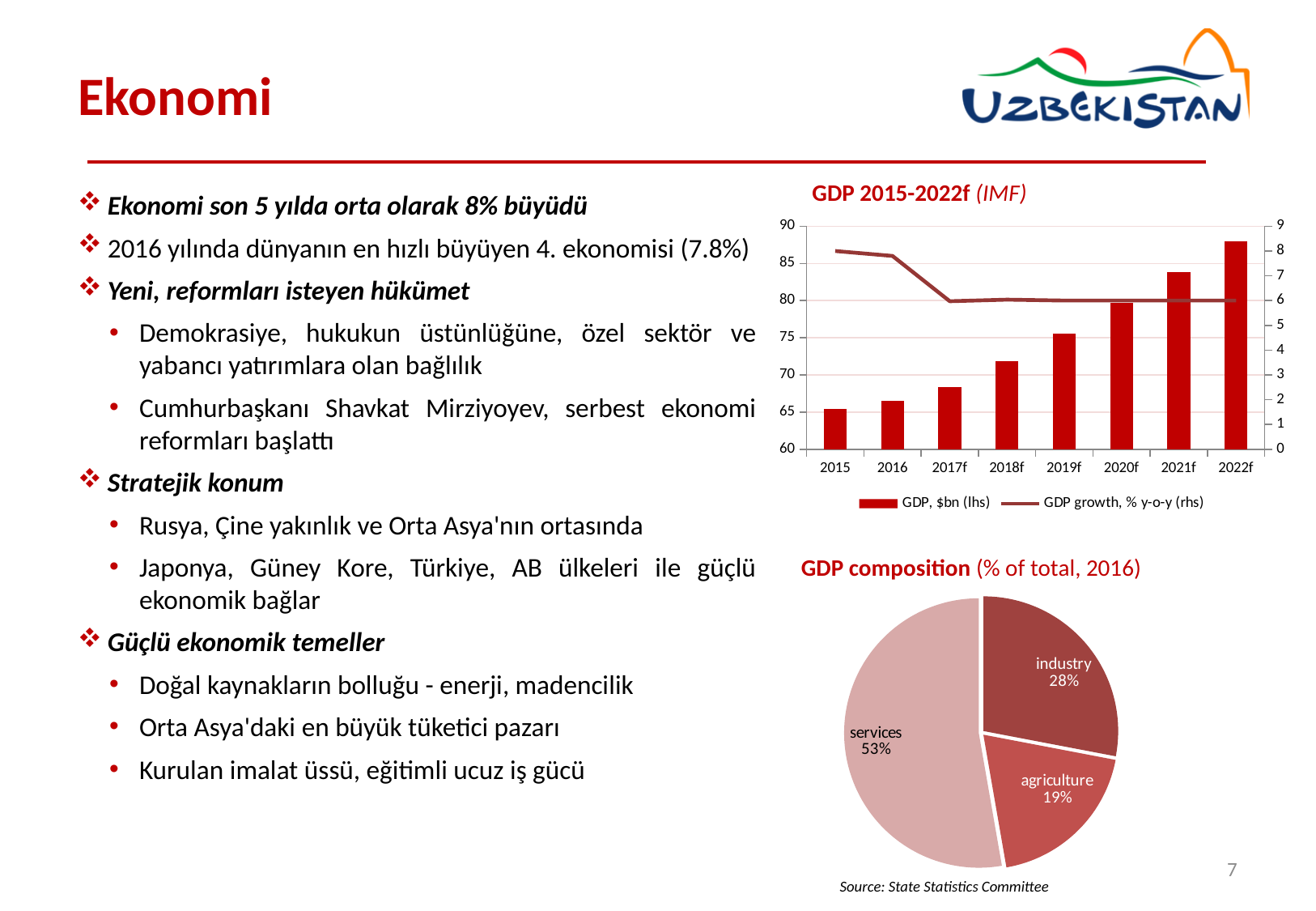
In the GDP 2015-2022f chart, is the GDP value for 2015 greater or less than 70? less In the GDP composition pie chart, what share of GDP does agriculture account for? 19% What kind of chart is the GDP 2015-2022f chart? Combined bar and line chart In the GDP 2015-2022f chart, is the GDP value for 2022f greater or less than 85? greater How many slices does the GDP composition pie chart have? 3 In the GDP composition pie chart, how many percentage points larger is the services share than the industry share? 25 How many series does the legend of the GDP 2015-2022f chart list? 2 In the GDP 2015-2022f chart, do the GDP bars rise or fall from 2015 to 2022f? rise In the GDP composition pie chart, which sector has the largest share? services In the GDP 2015-2022f chart, which year has the highest GDP in $bn? 2022f In the GDP composition pie chart, what share of GDP does industry account for? 28% In the GDP composition pie chart, which sector has the smallest share? agriculture